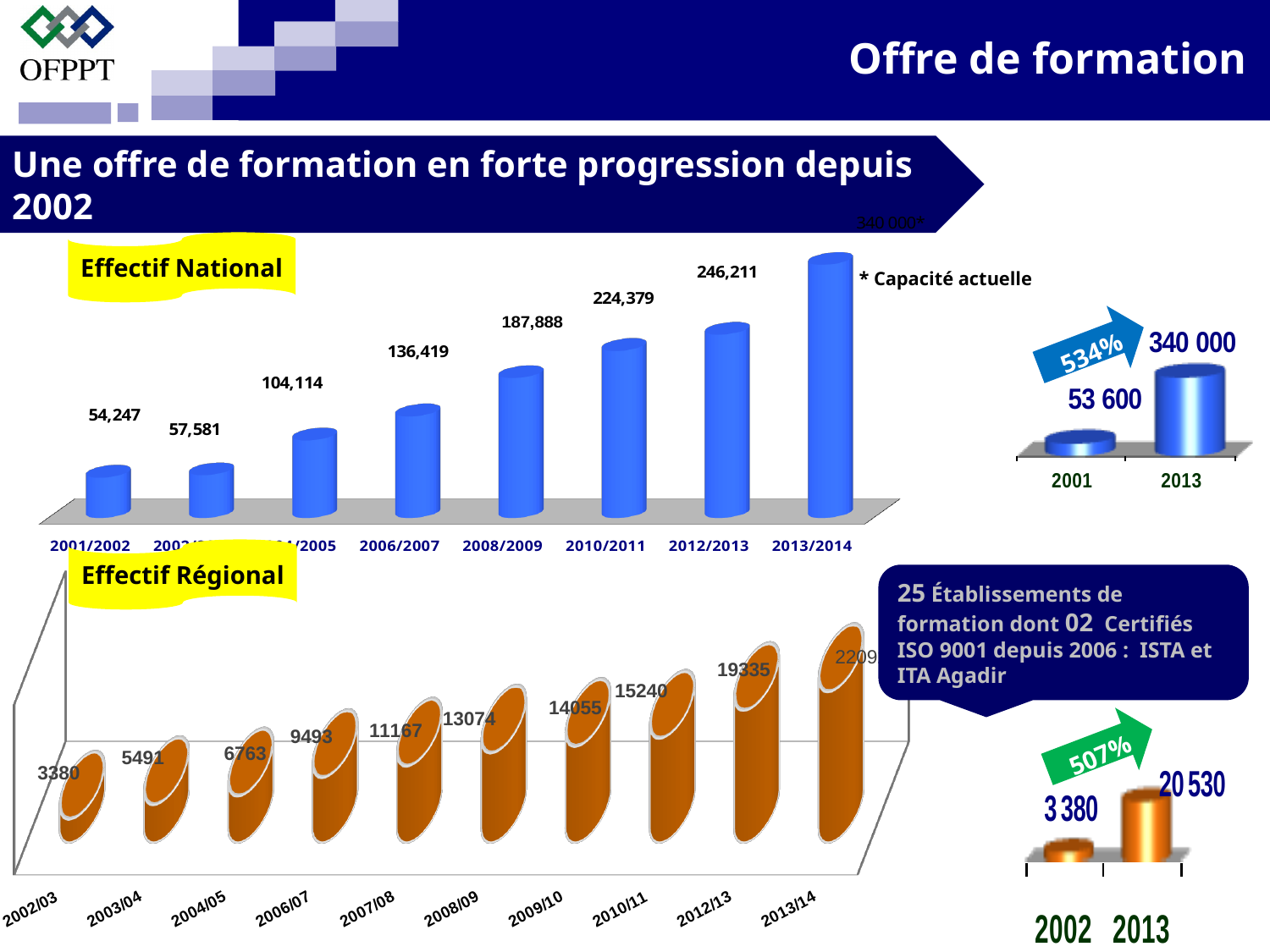
In the Effectif National chart, which year has the highest bar? 2013/2014 In the Effectif Régional chart, what is the value for 2002/03? 3380 In the Effectif National chart, what is the difference between the values for 2012/2013 and 2010/2011? 21,832 In the Effectif National chart, which year has the lowest value? 2001/2002 In the Effectif Régional chart, what is the difference between the values for 2012/13 and 2010/11? 4095 In the Effectif Régional chart, what is the value for 2008/09? 13074 In the Effectif National chart, what is the value for 2012/2013? 246,211 What kind of chart is the Effectif Régional chart? bar chart In the Effectif Régional chart, which is larger, the value for 2007/08 or for 2006/07? 2007/08 In the Effectif Régional chart, do the values rise or fall from 2002/03 to 2013/14? rise In the Effectif National chart, what is the value for 2006/2007? 136,419 How many bars are shown in the Effectif National chart? 8